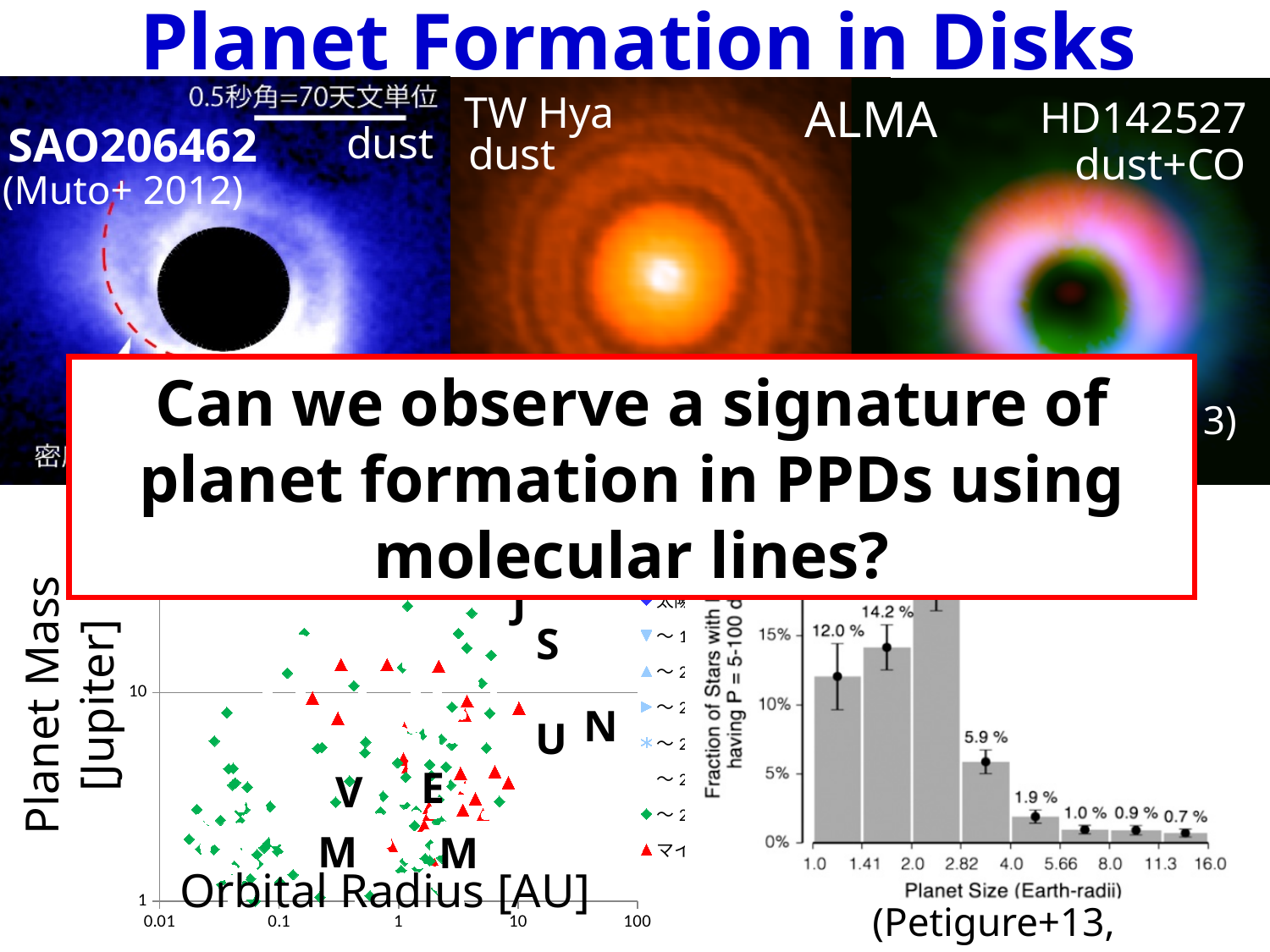
In the bar chart on the right, what is the fraction of stars with planets for the 1.41–2.0 Earth-radii bin? 14.2 % What kind of chart is the chart on the left with Planet Mass versus Orbital Radius? scatter plot In the bar chart on the right, what is the fraction of stars with planets for the 2.82–4.0 Earth-radii bin? 5.9 % In the bar chart on the right, is the value for the 2.82–4.0 bin greater or less than 5%? greater What is the x-axis label of the chart on the left? Orbital Radius [AU] In the bar chart on the right, what is the fraction of stars with planets for the 11.3–16.0 Earth-radii bin? 0.7 % In the bar chart on the right, what is the difference between the fractions for the 1.41–2.0 bin and the 2.82–4.0 bin? 8.3 % In the bar chart on the right, which planet-size bin has the lowest fraction of stars with planets? 11.3–16.0 Earth-radii In the bar chart on the right, which is larger: the fraction for the 1.0–1.41 bin or the 1.41–2.0 bin? 1.41–2.0 bin In the bar chart on the right, what is the fraction of stars with planets for the 1.0–1.41 Earth-radii bin? 12.0 % In the bar chart on the right, what is the fraction of stars with planets for the 4.0–5.66 Earth-radii bin? 1.9 % What kind of chart is the chart on the right (Petigure+13)? bar chart